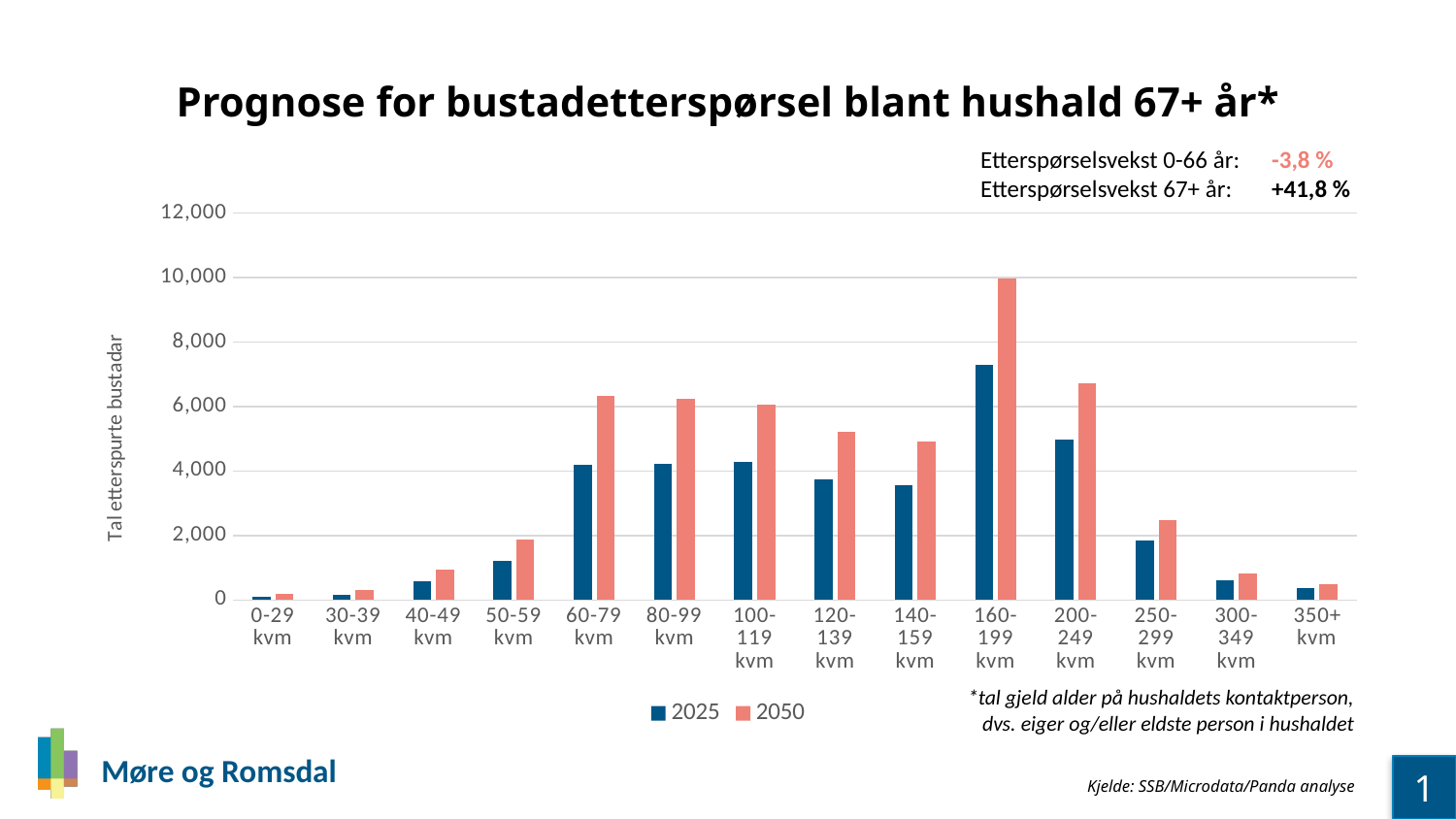
How many size categories are shown on the x axis? 14 Is the 2025 value for 50-59 kvm greater or less than 2,000? less Which category has the highest value for the 2025 series? 160-199 kvm Which category has the highest value for the 2050 series? 160-199 kvm How many series does the legend list? 2 What is the title of the chart? Prognose for bustadetterspørsel blant hushald 67+ år* For the 2025 series, which is larger: 160-199 kvm or 200-249 kvm? 160-199 kvm For 60-79 kvm, which series has the larger value, 2025 or 2050? 2050 Is the 2050 value for 160-199 kvm greater or less than 8,000? greater Which category has the lowest value for the 2050 series? 0-29 kvm What kind of chart is shown on the slide? Bar chart Is the 2025 value for 160-199 kvm greater or less than 6,000? greater